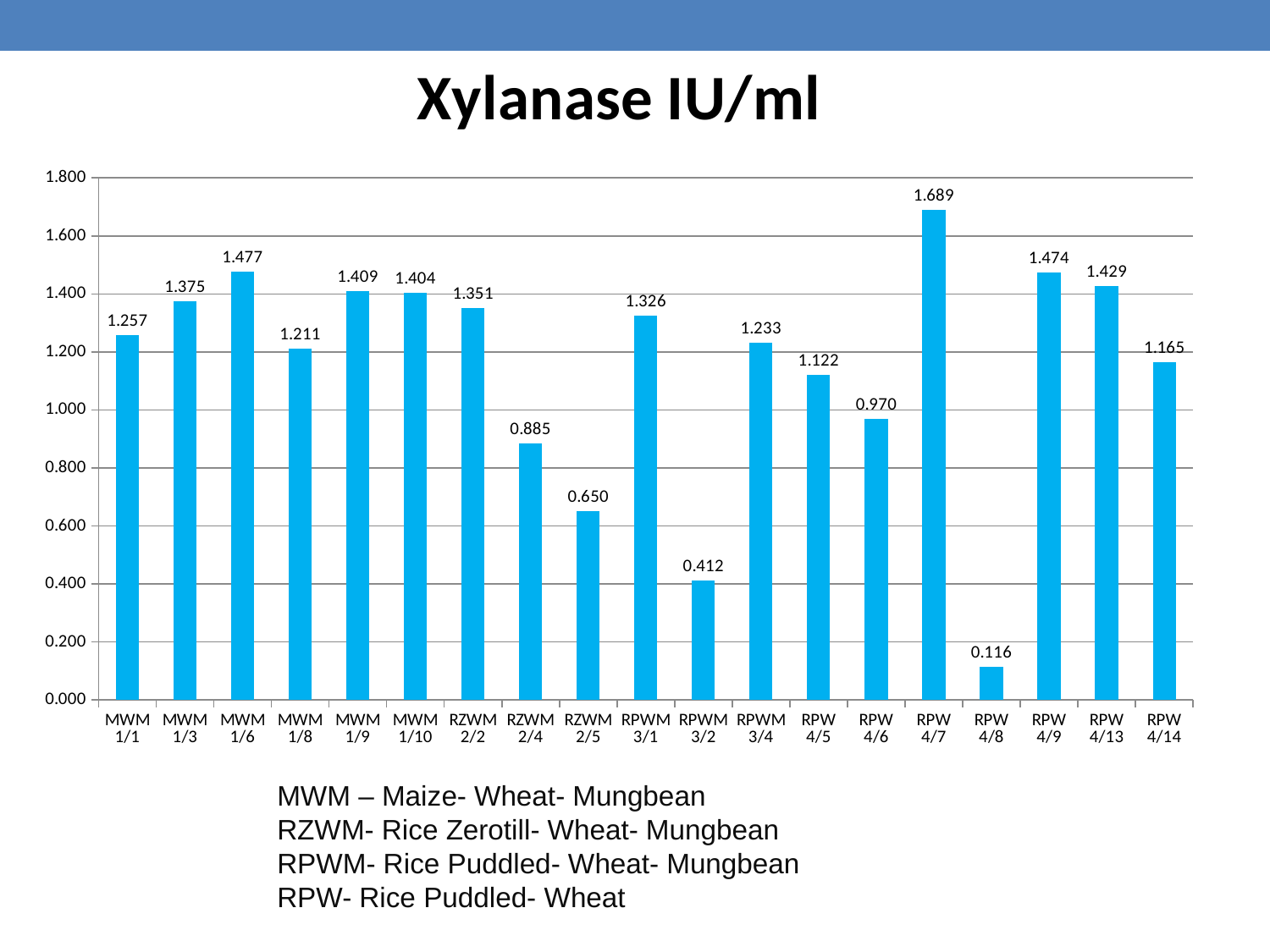
Which category has the highest xylanase value? RPW 4/7 What type of chart is shown on the slide? bar chart How many categories (bars) are plotted in the chart? 19 Which category has the lowest xylanase value? RPW 4/8 What is the title of the chart? Xylanase IU/ml What is the difference between the xylanase values for RPW 4/7 and RPW 4/8? 1.573 What is the xylanase value for RPWM 3/2? 0.412 What is the xylanase value for RZWM 2/4? 0.885 What is the difference between the xylanase values for RZWM 2/4 and RZWM 2/5? 0.235 Is the value for RPW 4/7 greater or less than 1.600? greater Which has a larger xylanase value, RPWM 3/1 or RPWM 3/2? RPWM 3/1 What is the xylanase value for MWM 1/6? 1.477